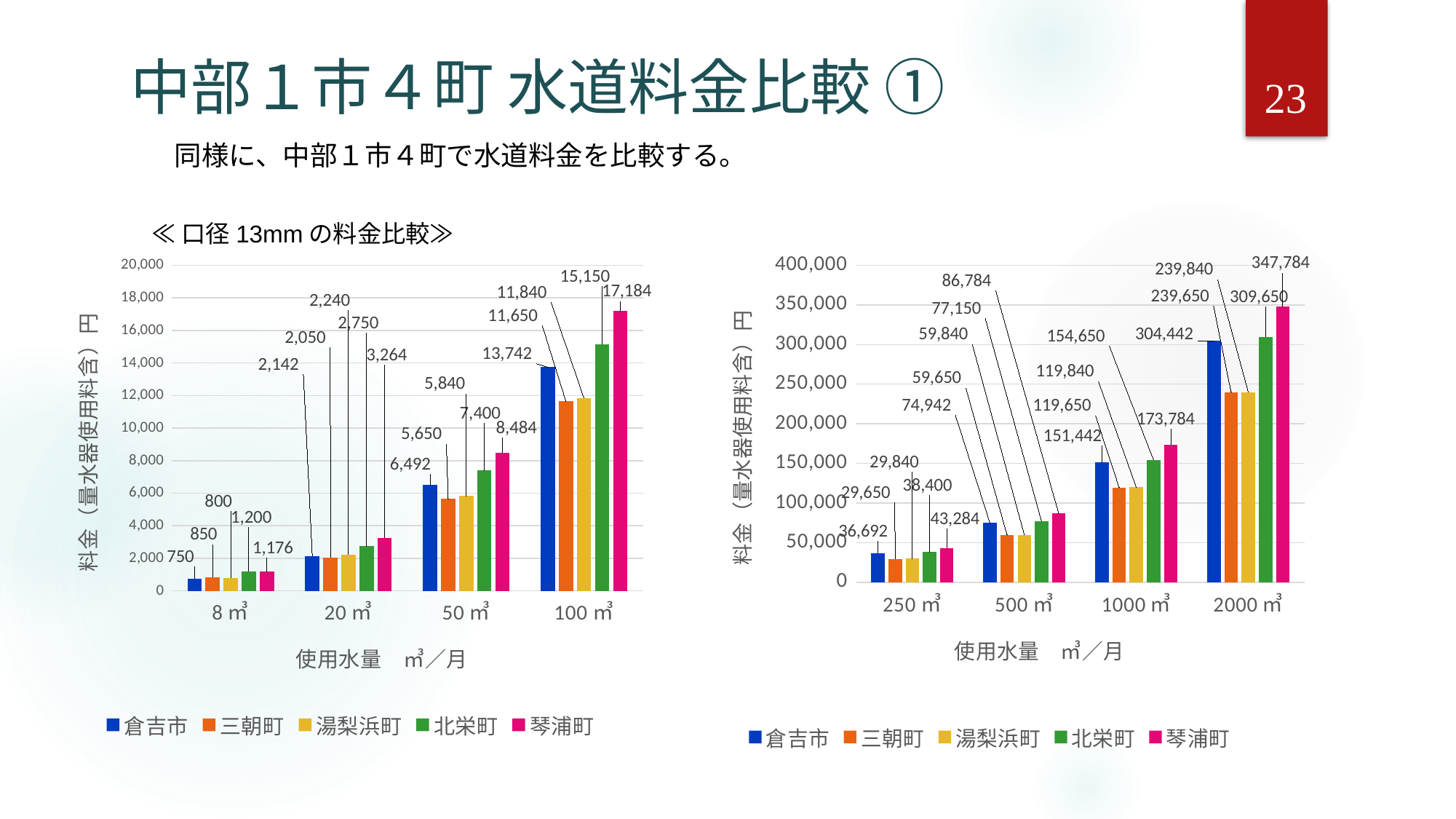
In the left chart, which municipality has the lowest value at 100 ㎥? 三朝町 In the right chart, which is larger at 500 ㎥: 倉吉市 or 北栄町? 北栄町 In the right chart, what is the value for 北栄町 at 1000 ㎥? 154,650 What type of chart is the left chart? bar chart In the right chart, is the value for 倉吉市 at 2000 ㎥ greater or less than 250,000? greater In the left chart, what is the value for 琴浦町 at 100 ㎥? 17,184 In the right chart, what is the value for 三朝町 at 2000 ㎥? 239,650 How many usage-volume categories are shown on the x axis of the left chart? 4 In the left chart, what is the difference between 琴浦町 and 倉吉市 at 20 ㎥? 1,122 How many series does the legend of the right chart list? 5 In the left chart, what is the value for 倉吉市 at 50 ㎥? 6,492 In the right chart, which municipality has the highest value at 2000 ㎥? 琴浦町